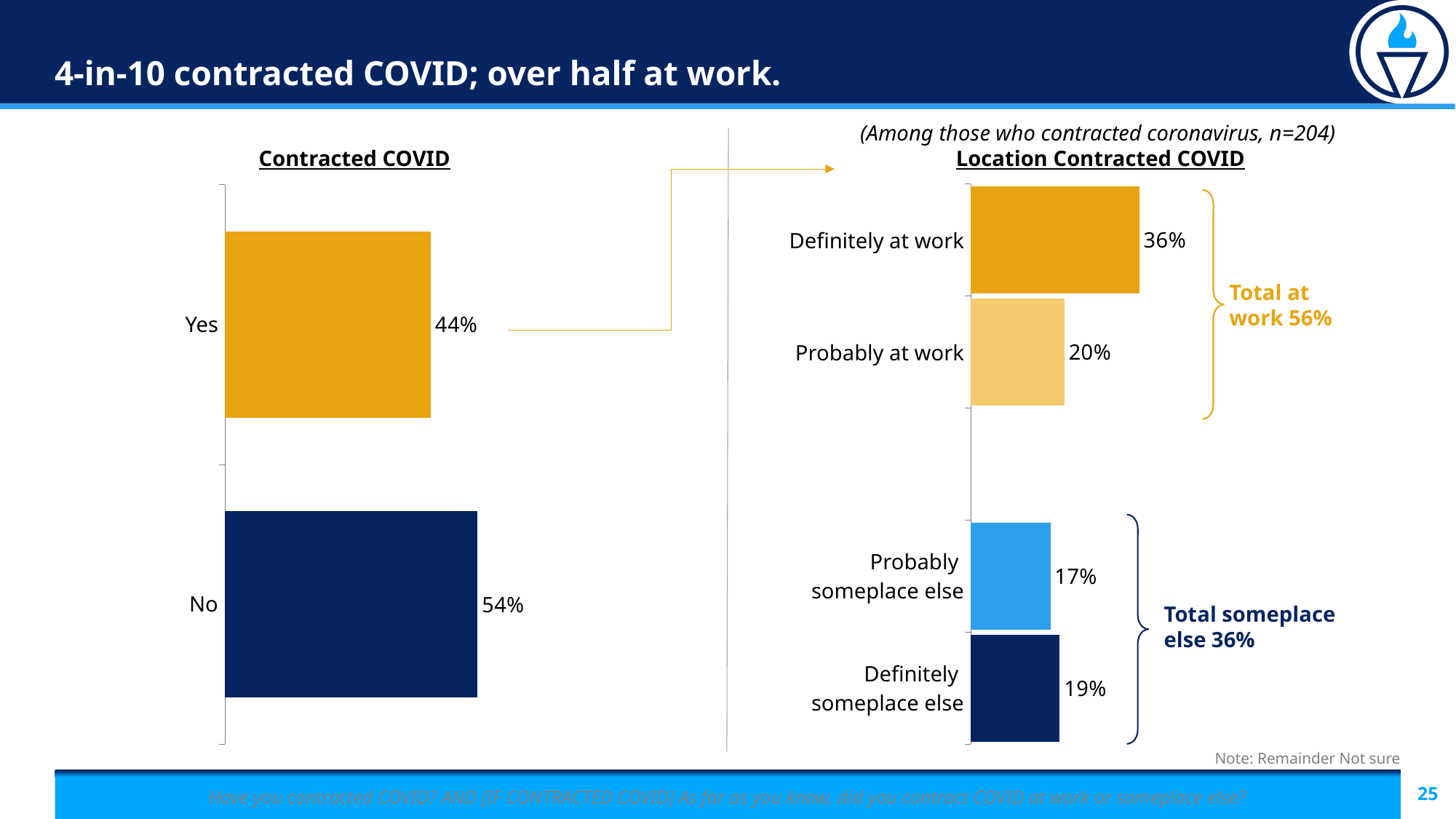
In the 'Location Contracted COVID' chart, which category has the highest value? Definitely at work In the 'Location Contracted COVID' chart, what percentage said 'Probably someplace else'? 17% In the 'Location Contracted COVID' chart, which category has the lowest value? Probably someplace else In the 'Location Contracted COVID' chart, what percentage said 'Definitely someplace else'? 19% In the 'Contracted COVID' chart, what is the difference between the No and Yes percentages? 10% In the 'Contracted COVID' chart, which category has the higher value, Yes or No? No In the 'Contracted COVID' chart, what percentage answered Yes? 44% In the 'Location Contracted COVID' chart, what percentage said 'Definitely at work'? 36% In the 'Location Contracted COVID' chart, how many categories are shown? 4 In the 'Contracted COVID' chart, what percentage answered No? 54% In the 'Location Contracted COVID' chart, what percentage said 'Probably at work'? 20% What type of chart is the 'Contracted COVID' chart? Bar chart